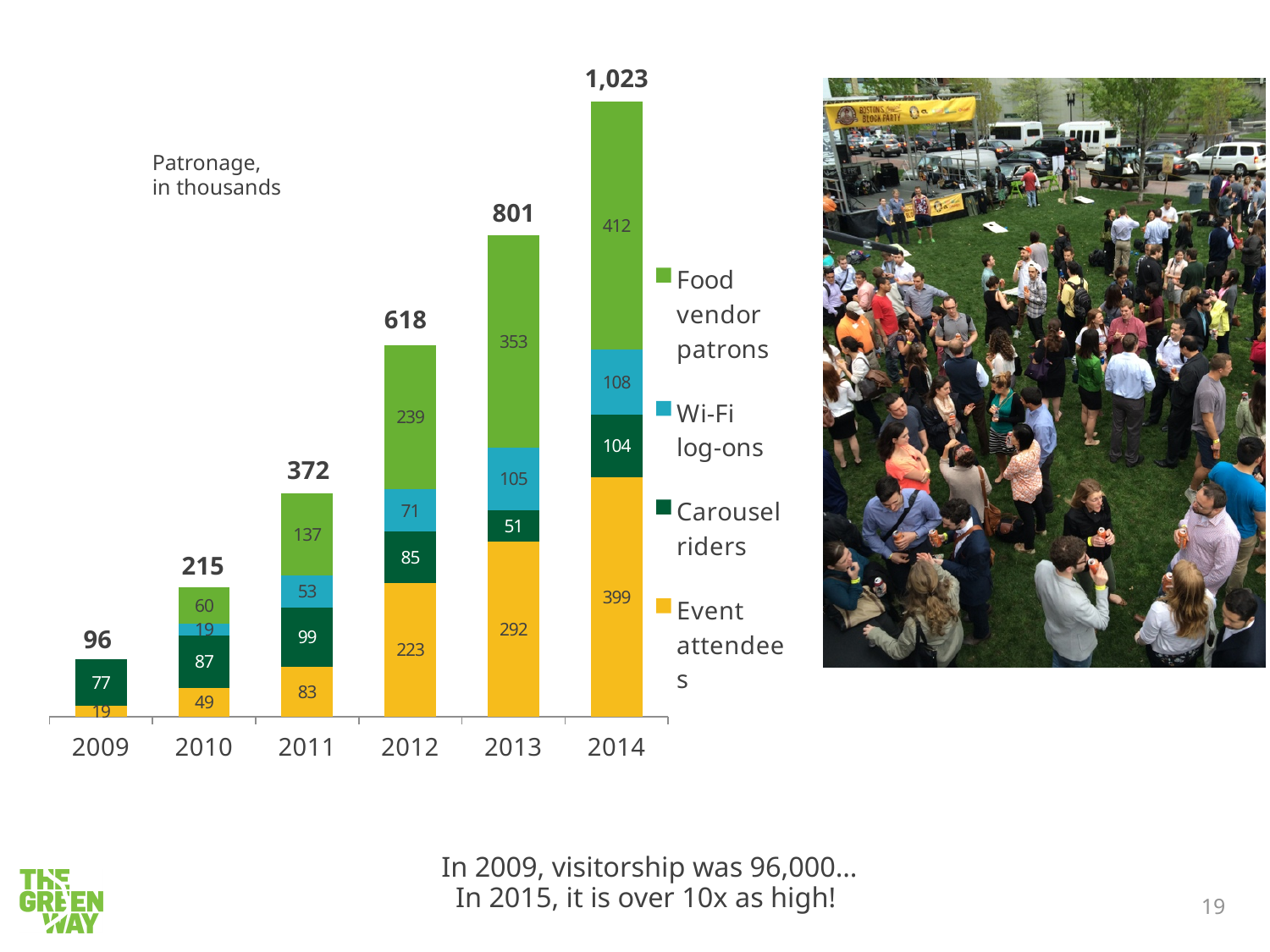
What is the value for Food vendor patrons in 2012? 239 Which year has the highest total patronage? 2014 What is the value for Event attendees in 2013? 292 Which year has the lowest total patronage? 2009 Which is larger in 2014: Food vendor patrons or Event attendees? Food vendor patrons How many series does the legend list? 4 What is the total patronage shown for 2014? 1,023 What is the difference between the total patronage in 2014 and in 2013? 222 How many years are shown on the x axis? 6 What is the value for Carousel riders in 2009? 77 What is the value for Wi-Fi log-ons in 2011? 53 What kind of chart is shown on the slide? Stacked bar chart